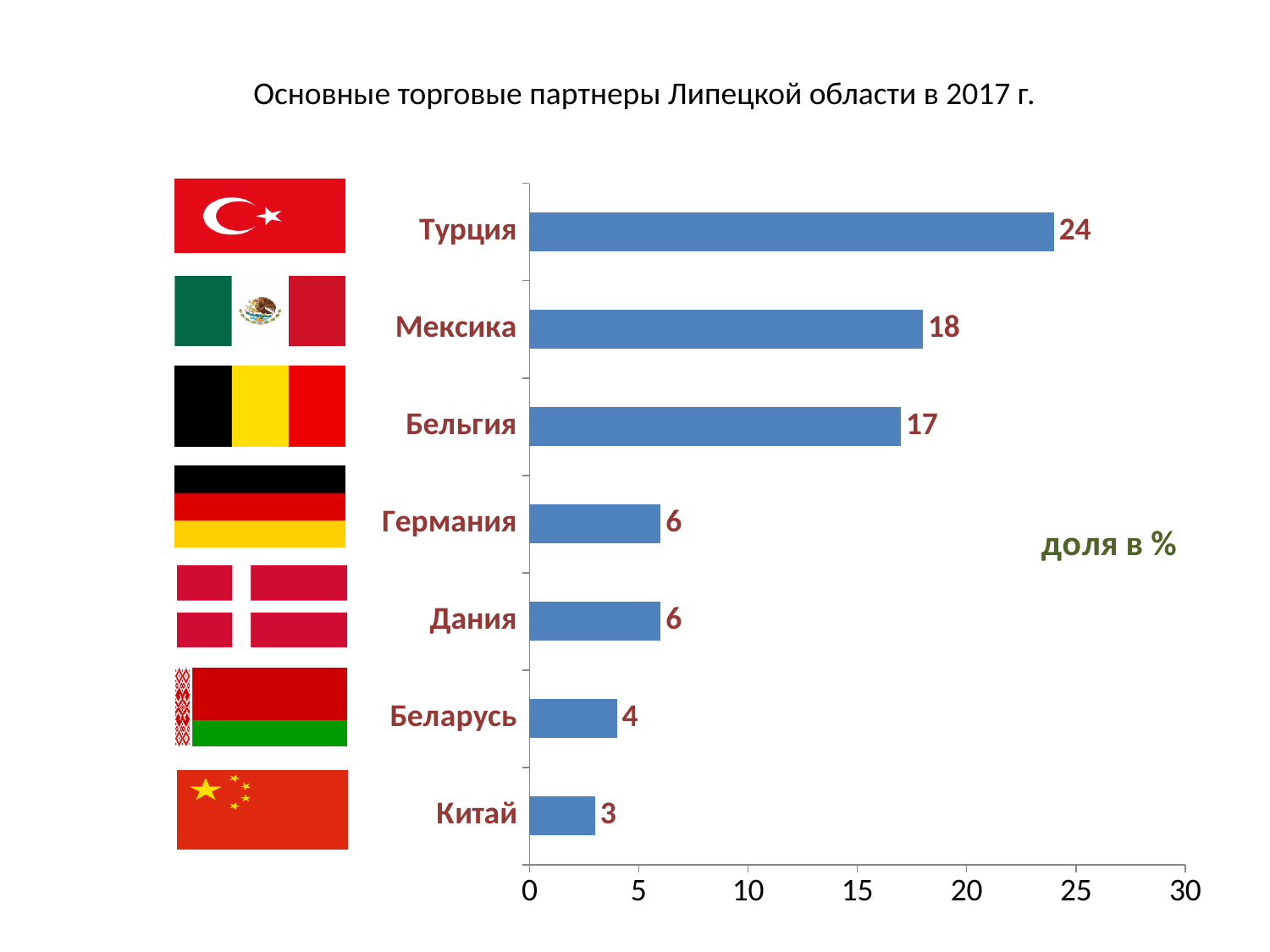
Is the value for Мексика greater or less than 15? greater Which country has the highest value? Турция What is the difference between the values for Турция and Мексика? 6 What is the value for Беларусь? 4 Which country has the lowest value? Китай What kind of chart is shown on the slide? bar chart How many countries are shown in the chart? 7 What is the value for Турция? 24 Which is larger, the value for Германия or the value for Беларусь? Германия What is the title of the slide? Основные торговые партнеры Липецкой области в 2017 г. What unit label is shown next to the chart? доля в % What is the value for Бельгия? 17